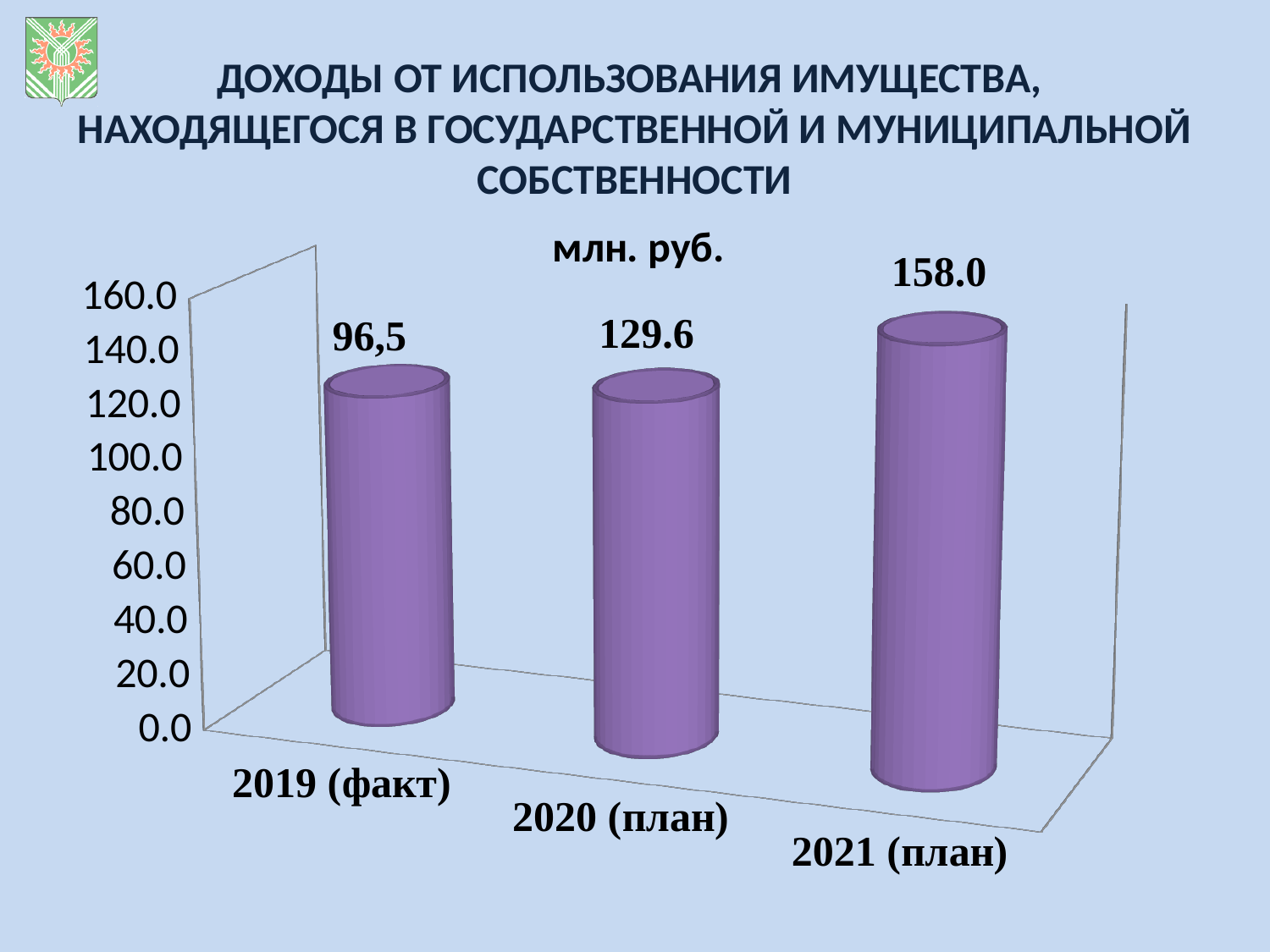
Which is larger, the value for 2020 (план) or the value for 2019 (факт)? 2020 (план) What unit is given in the chart title? млн. руб. Do the values rise or fall from 2019 (факт) to 2021 (план)? rise Which category has the lowest value? 2019 (факт) What is the value for 2019 (факт)? 96,5 What is the value for 2021 (план)? 158.0 Which category has the highest value? 2021 (план) Is the value for 2021 (план) greater or less than 140? greater What kind of chart is shown on the slide? bar chart What is the value for 2020 (план)? 129.6 What is the difference between the values for 2021 (план) and 2020 (план)? 28.4 How many categories are shown on the chart? 3